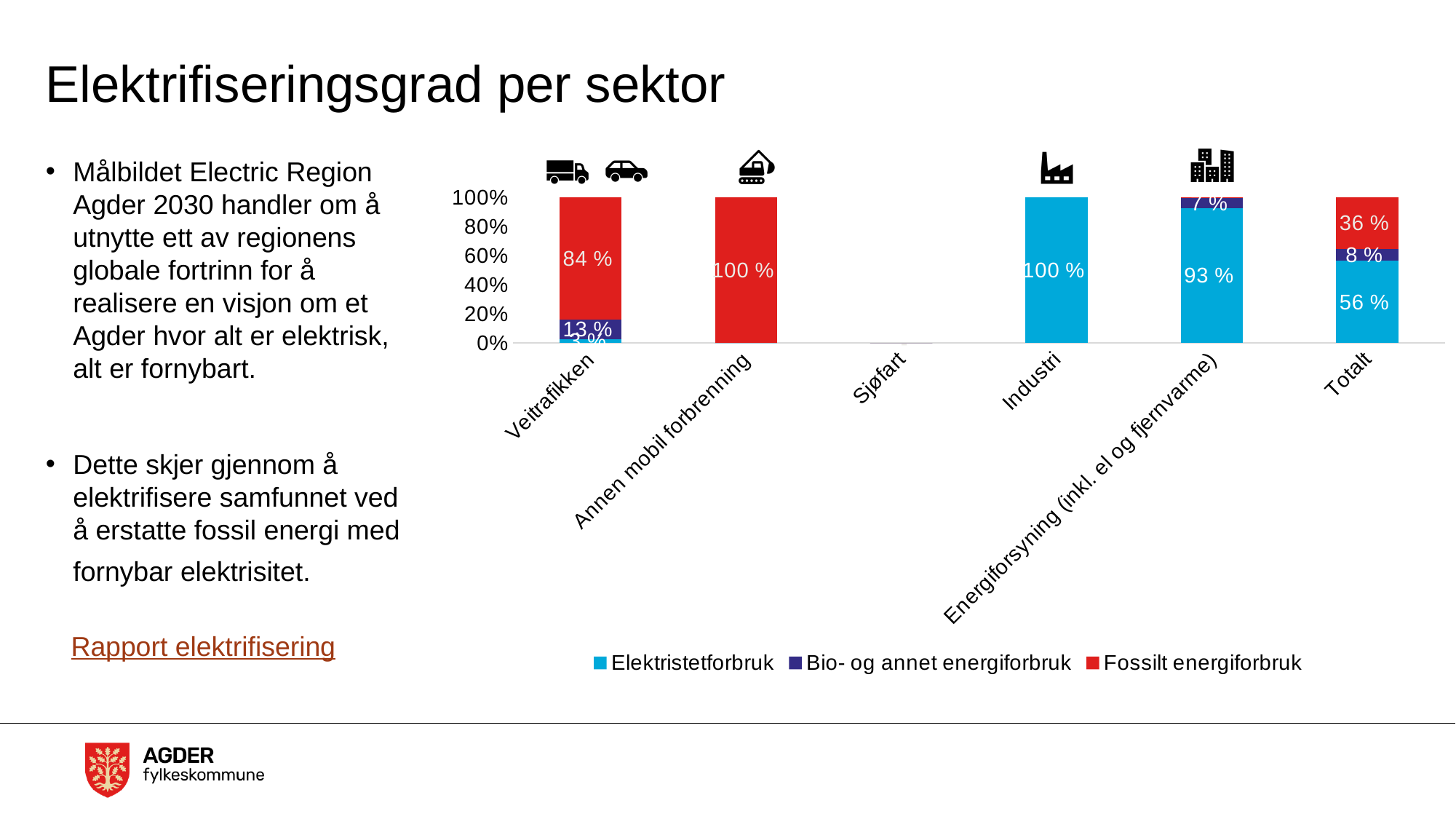
How many sector categories are shown on the x axis? 6 What is the share of Bio- og annet energiforbruk for Energiforsyning (inkl. el og fjernvarme)? 7 % What is the share of Elektristetforbruk for Energiforsyning (inkl. el og fjernvarme)? 93 % What kind of chart is shown on the slide? Stacked bar chart How many series does the legend list? 3 What is the share of Fossilt energiforbruk for Totalt? 36 % What is the share of Elektristetforbruk for Totalt? 56 % What is the share of Elektristetforbruk for Industri? 100 % What is the share of Fossilt energiforbruk for Annen mobil forbrenning? 100 % What is the share of Fossilt energiforbruk for Veitrafikken? 84 % For Totalt, how many percentage points larger is Elektristetforbruk than Fossilt energiforbruk? 20 Which series is shown in red in the legend? Fossilt energiforbruk